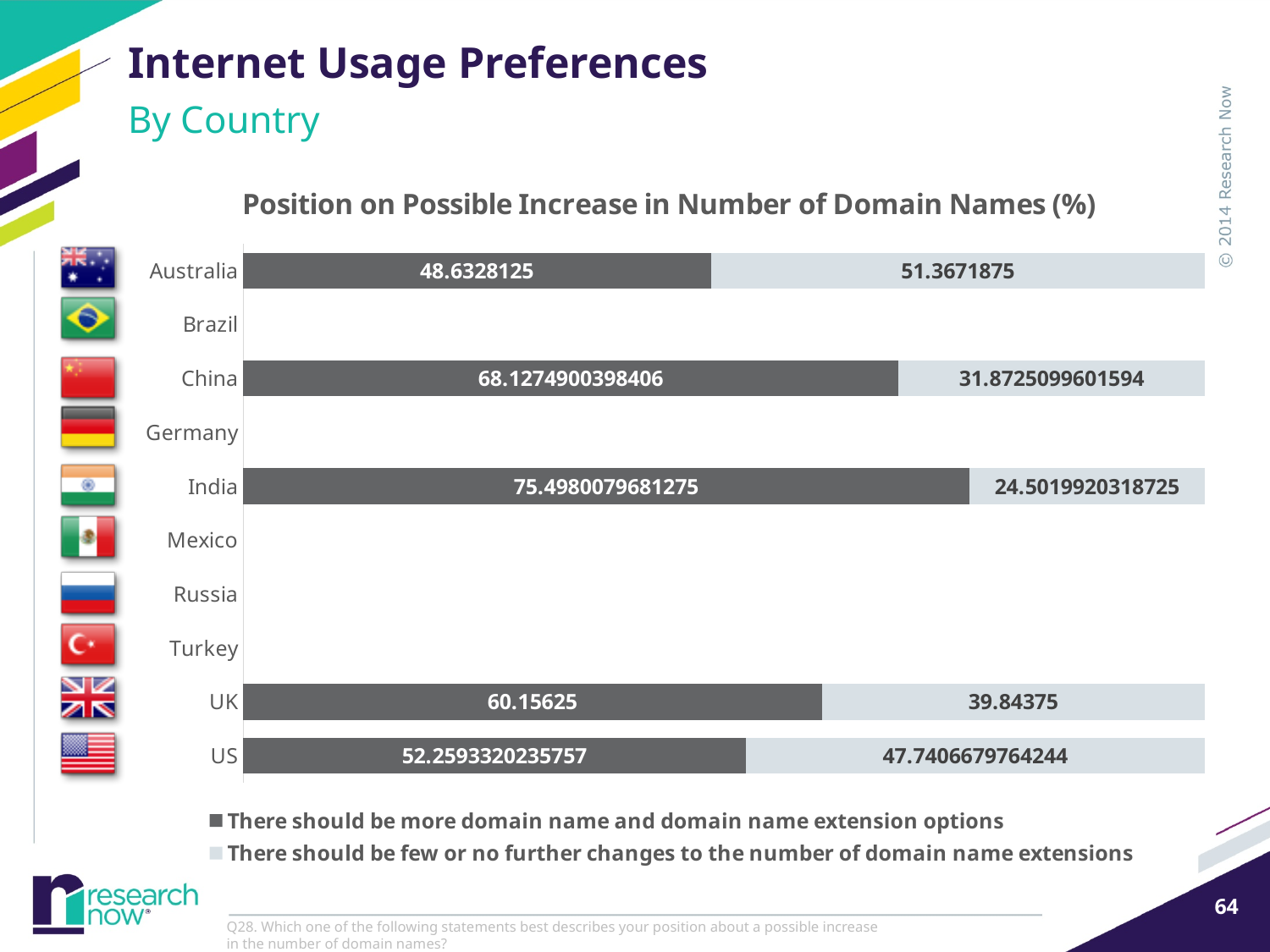
How many countries are listed on the chart's axis? 10 Which country has the highest value for 'There should be more domain name and domain name extension options'? India What kind of chart is shown on the slide? Stacked bar chart What is the value for China for 'There should be more domain name and domain name extension options'? 68.1274900398406 What is the value for the US for 'There should be few or no further changes to the number of domain name extensions'? 47.7406679764244 What is the value for the UK for 'There should be few or no further changes to the number of domain name extensions'? 39.84375 Which is larger: China's value or the UK's value for 'There should be more domain name and domain name extension options'? China How many series does the legend list? 2 What is the difference between the two values shown for the UK? 20.3125 What is the value for India for 'There should be more domain name and domain name extension options'? 75.4980079681275 Among the countries with data plotted, which has the lowest value for 'There should be more domain name and domain name extension options'? Australia What is the total of the two values shown for Australia? 100